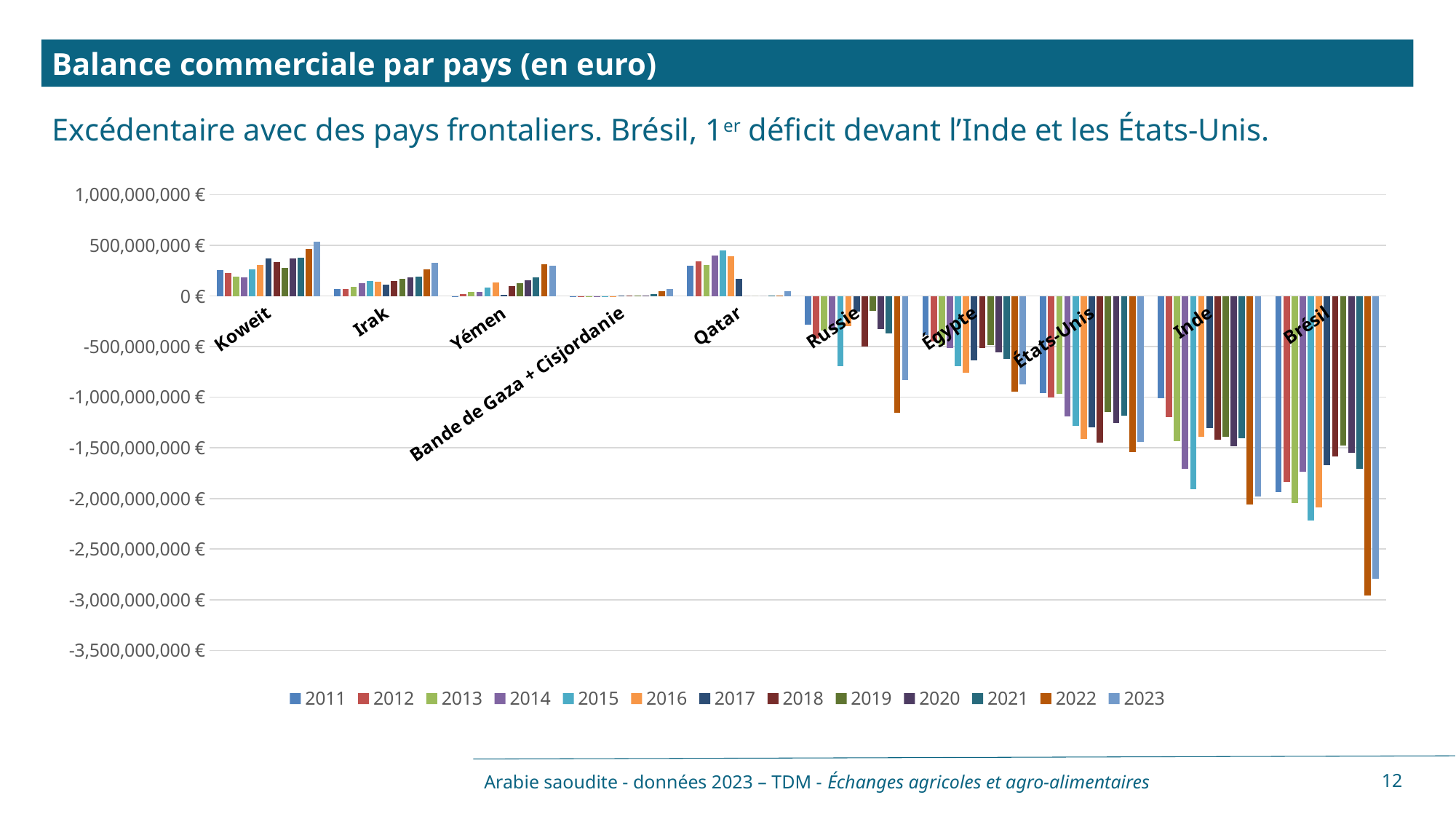
Is the value for Russie in 2022 greater or less than -1,000,000,000 €? less Which years are the first and last series listed in the legend? 2011 and 2023 Is the value for Inde in 2015 greater or less than -1,500,000,000 €? less Which country has the lowest (most negative) bar in the chart? Brésil Is the value for Brésil in 2022 greater or less than -2,500,000,000 €? less Which is larger, the 2023 value for Koweit or the 2023 value for Irak? Koweit Which country has the highest positive bar in the chart? Koweit How many series (years) does the legend list? 13 What kind of chart is shown on the slide? Bar chart What is the title of the chart on the slide? Balance commerciale par pays (en euro) How many countries (categories) are shown on the x axis of the chart? 10